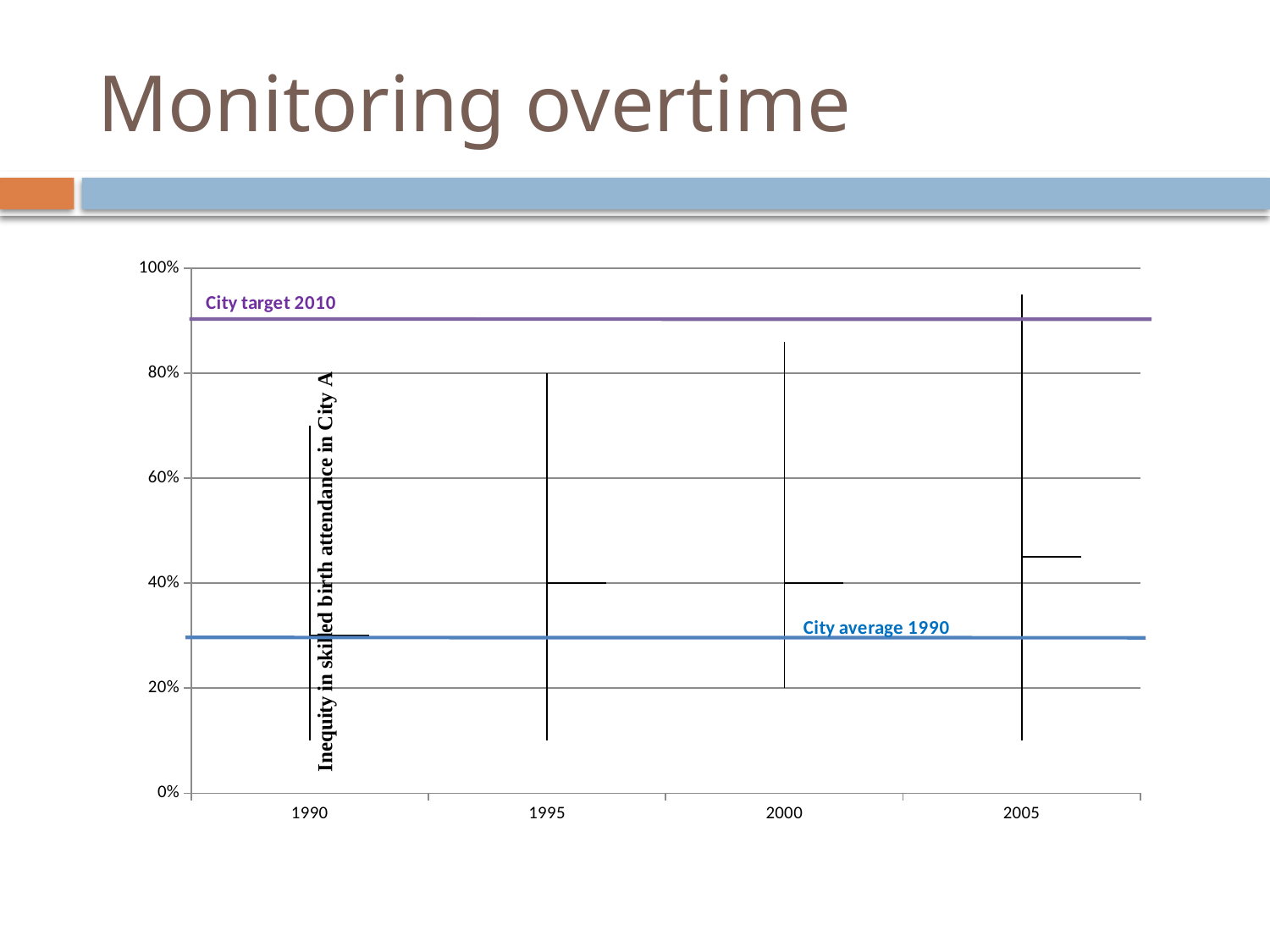
What is the label on the vertical axis of the chart? Inequity in skilled birth attendance in City A Is the City target 2010 line greater or less than 80%? greater How many years are marked on the x axis of the chart? 4 Is the top of the vertical line for 2000 greater or less than 80%? greater Which year has the vertical line reaching the highest value? 2005 Do the horizontal markers rise or fall from 1990 to 2005? rise What are the two labelled horizontal reference lines on the chart called? City target 2010 and City average 1990 Is the horizontal marker for 1990 greater or less than 40%? less Which year has the vertical line with the lowest top end? 1990 Which is larger, the horizontal marker for 2005 or the horizontal marker for 1990? 2005